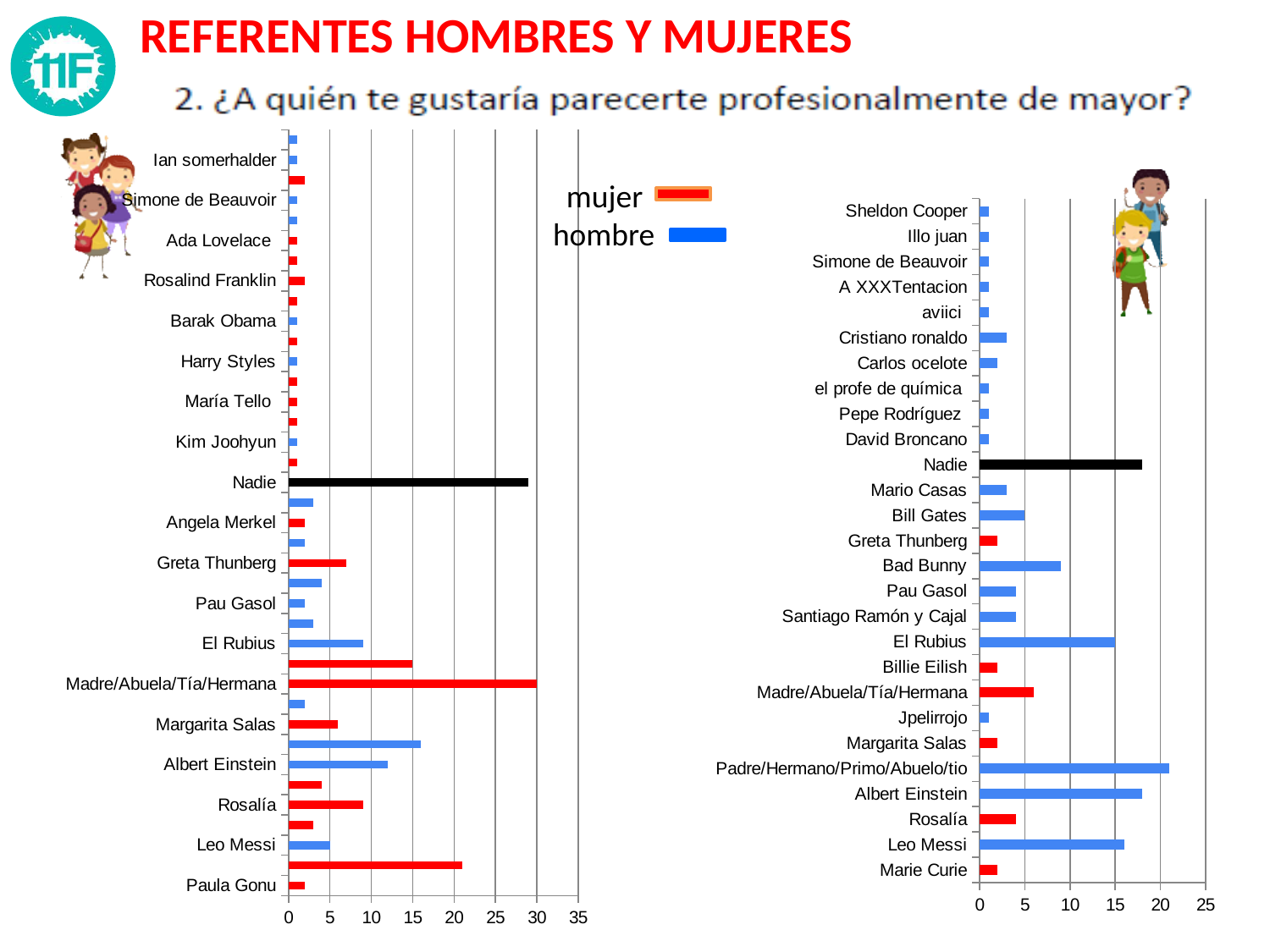
In the right chart, which category has the longest bar? Padre/Hermano/Primo/Abuelo/tio How many categories are listed on the right chart? 27 In the right chart, which is larger, the value for Leo Messi or the value for Bill Gates? Leo Messi In the right chart, is the value for Bad Bunny greater or less than 10? less What colour represents 'mujer' in the legend? red In the right chart, is the value for Marie Curie greater or less than 5? less How many series does the legend list? 2 What kind of chart is the left chart on the slide? bar chart In the left chart, is the value for El Rubius greater or less than 10? less In the left chart, which is larger, the value for Rosalía or the value for Margarita Salas? Rosalía